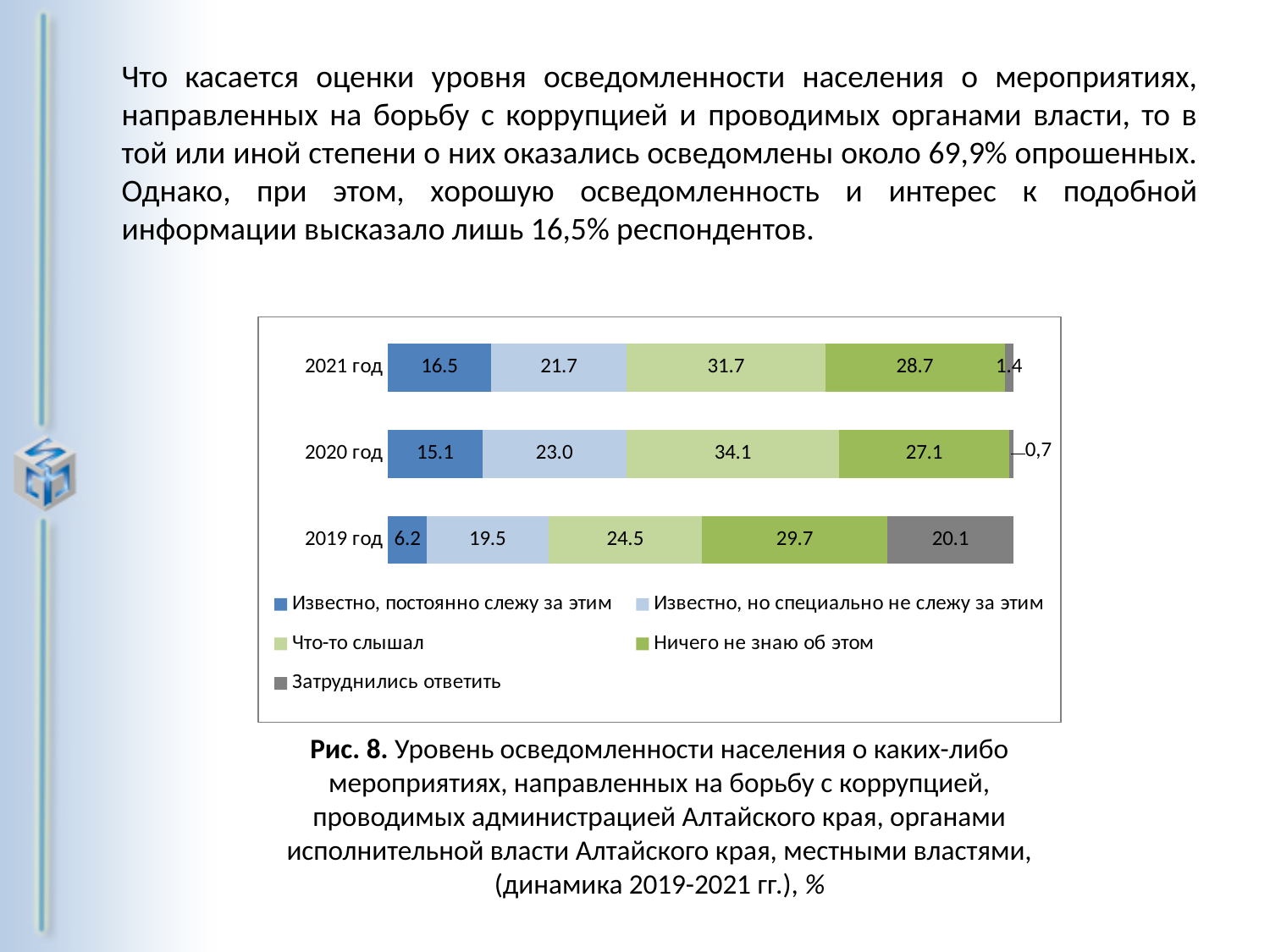
What is the value for "Что-то слышал" in 2020 год? 34.1 What is the value for "Ничего не знаю об этом" in 2021 год? 28.7 What is the value for "Известно, постоянно слежу за этим" in 2021 год? 16.5 What is the difference between the "Известно, но специально не слежу за этим" values for 2020 год and 2019 год? 3.5 Which year has the highest value for "Известно, постоянно слежу за этим"? 2021 год Which is larger: the "Что-то слышал" value for 2021 год or for 2019 год? 2021 год Does the value for "Известно, постоянно слежу за этим" rise or fall from 2019 год to 2021 год? Rise How many years (categories) are shown in the chart? 3 How many series does the legend list? 5 What type of chart is shown on the slide? Stacked bar chart Which year has the lowest value for "Затруднились ответить"? 2020 год What is the value for "Затруднились ответить" in 2019 год? 20.1